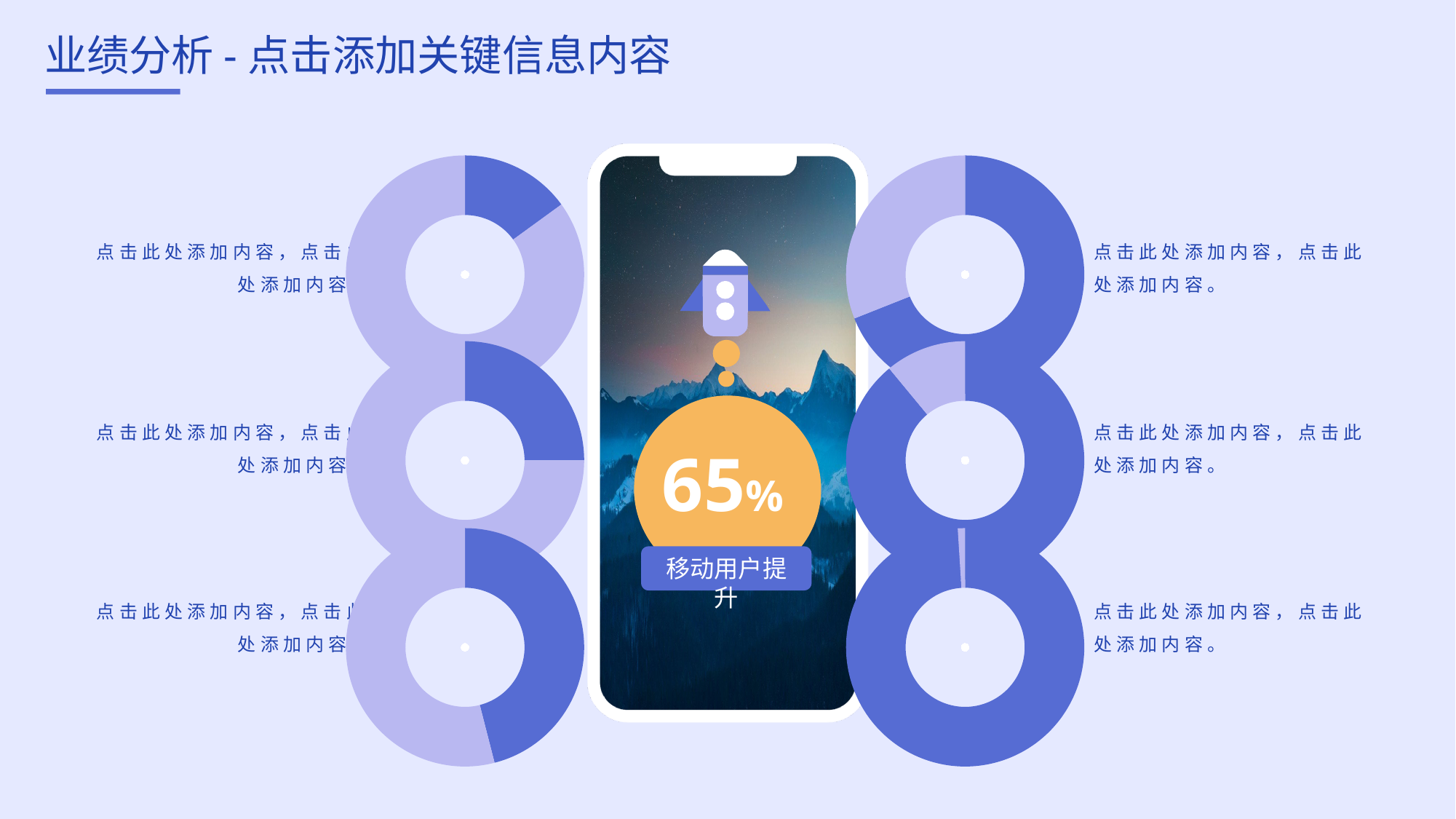
Of the three donut charts on the right, which one has the smallest light purple slice? The bottom-right one How many donut charts are on the slide in total? 6 In the bottom-right donut chart, which slice is larger, the dark blue one or the light purple one? The dark blue one Of the three donut charts on the left, which one has the smallest dark blue slice? The top-left one What kind of charts are shown on the left and right sides of the slide? Donut (pie) charts In the middle-left donut chart, which slice is larger, the light purple one or the dark blue one? The light purple one In the top-left donut chart, which slice is larger, the light purple one or the dark blue one? The light purple one What label appears below the 65% figure on the phone graphic? 移动用户提升 How many slices does the top-left donut chart have? 2 What percentage is printed in the orange circle on the phone in the centre of the slide? 65%